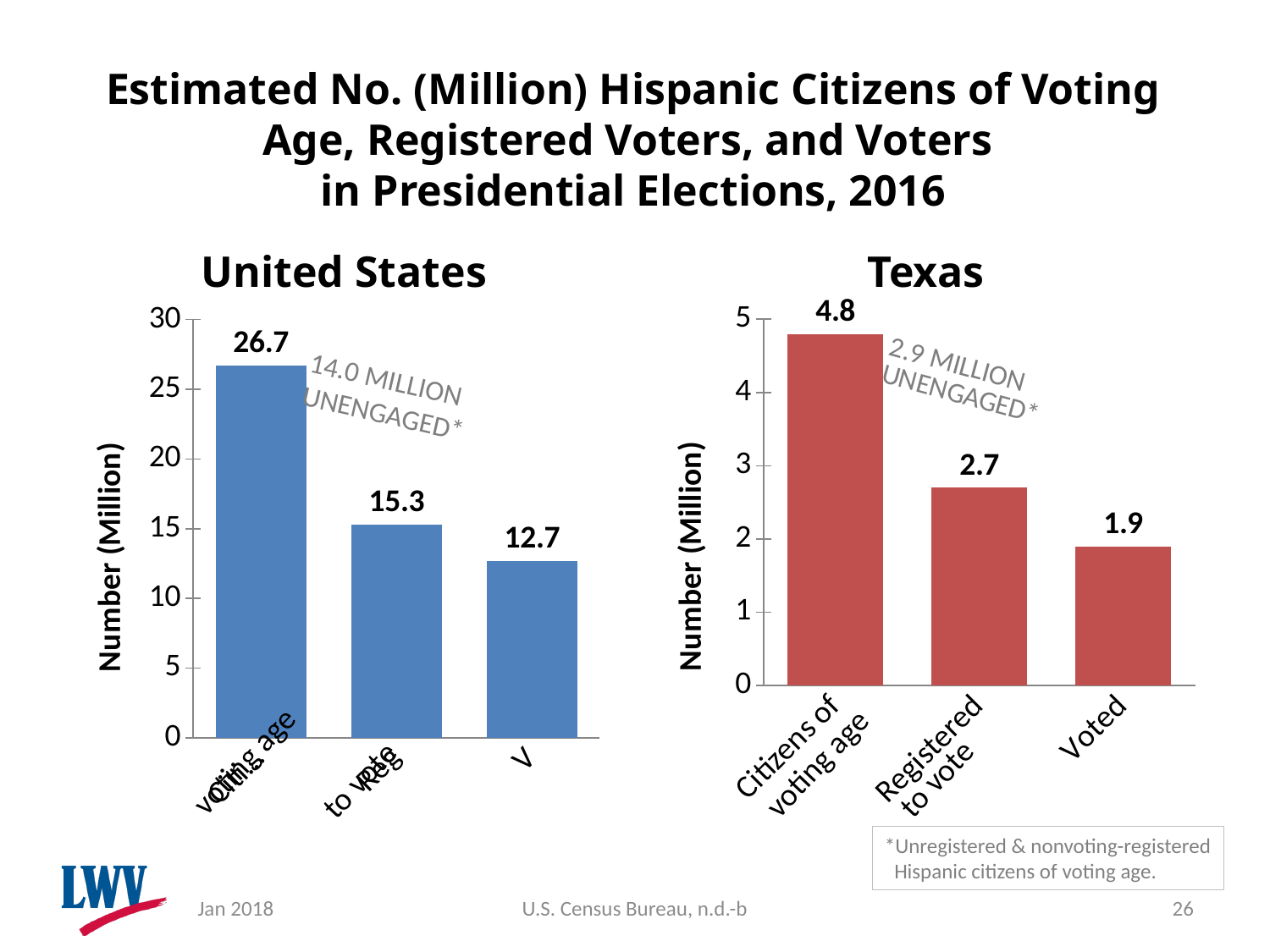
In the Texas chart, which category has the highest value? Citizens of voting age In the Texas chart, which category has the lowest value? Voted In the United States chart, what is the difference between the first bar (26.7) and the second bar (15.3)? 11.4 In the United States chart, what is the value of the first (tallest) bar? 26.7 In the Texas chart, what is the difference between Citizens of voting age and Registered to vote? 2.1 In the United States chart, what is the value of the third bar? 12.7 In the Texas chart, what is the value for Voted? 1.9 In the Texas chart, what is the value for Registered to vote? 2.7 In the Texas chart, is the value for Registered to vote greater or less than Voted? greater What type of chart is the United States chart? bar chart How many bars does the Texas chart have? 3 In the Texas chart, what is the value for Citizens of voting age? 4.8